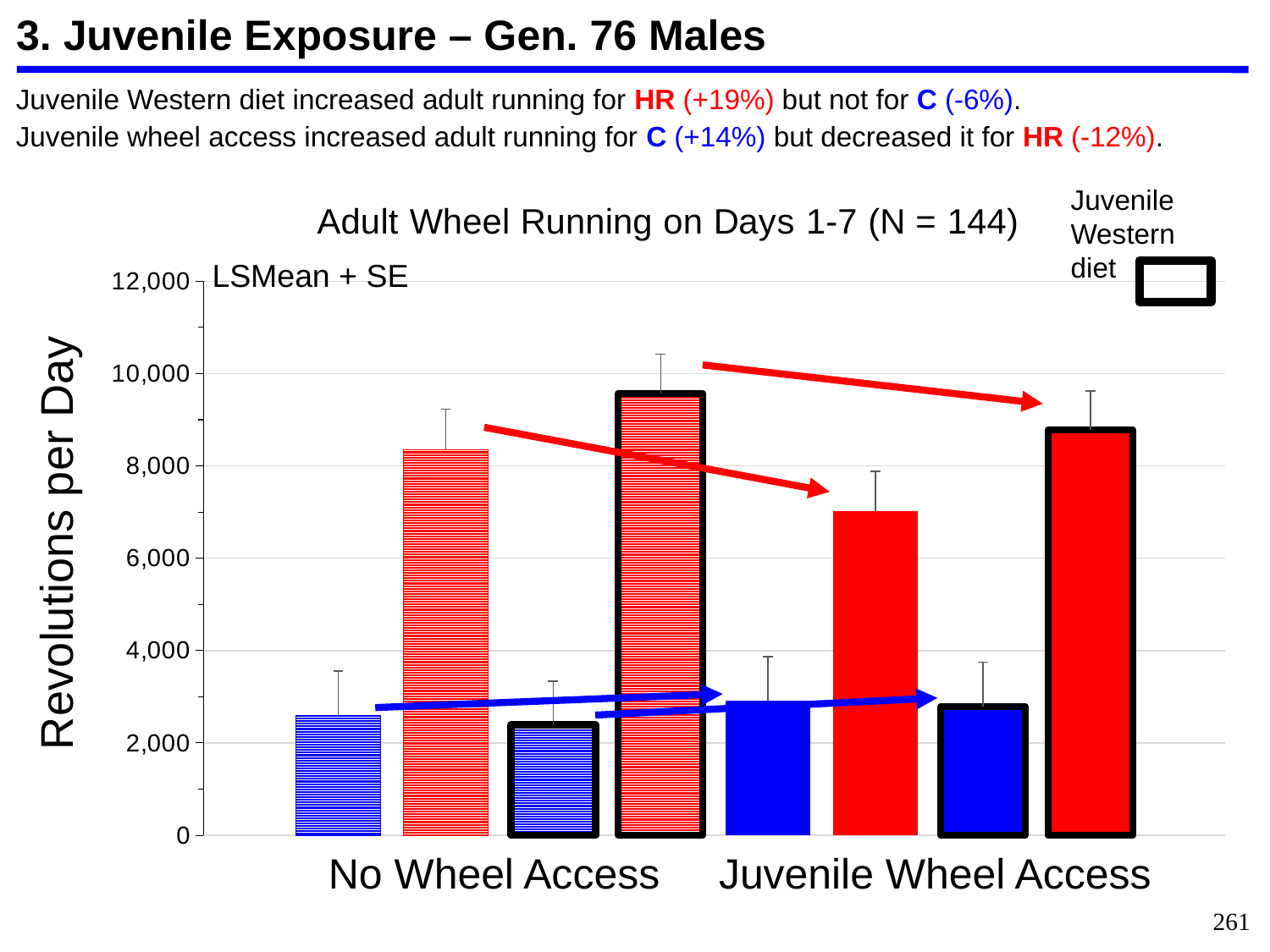
Is the value for the solid blue bar (no black outline) in the No Wheel Access group greater or less than 4,000? less Is the value for the black-outlined blue bar in the Juvenile Wheel Access group greater or less than 4,000? less Which group contains the tallest bar in the chart, No Wheel Access or Juvenile Wheel Access? No Wheel Access Is the value for the black-outlined red bar in the Juvenile Wheel Access group greater or less than 8,000? greater How many categories are shown on the x axis of the chart? 2 In the No Wheel Access group, which is larger: the solid red bar or the solid blue bar? the solid red bar What type of chart is shown on the slide? bar chart What is the title of the chart? Adult Wheel Running on Days 1-7 (N = 144) In the Juvenile Wheel Access group, which is larger: the black-outlined red bar or the solid red bar? the black-outlined red bar What is the label on the vertical axis of the chart? Revolutions per Day